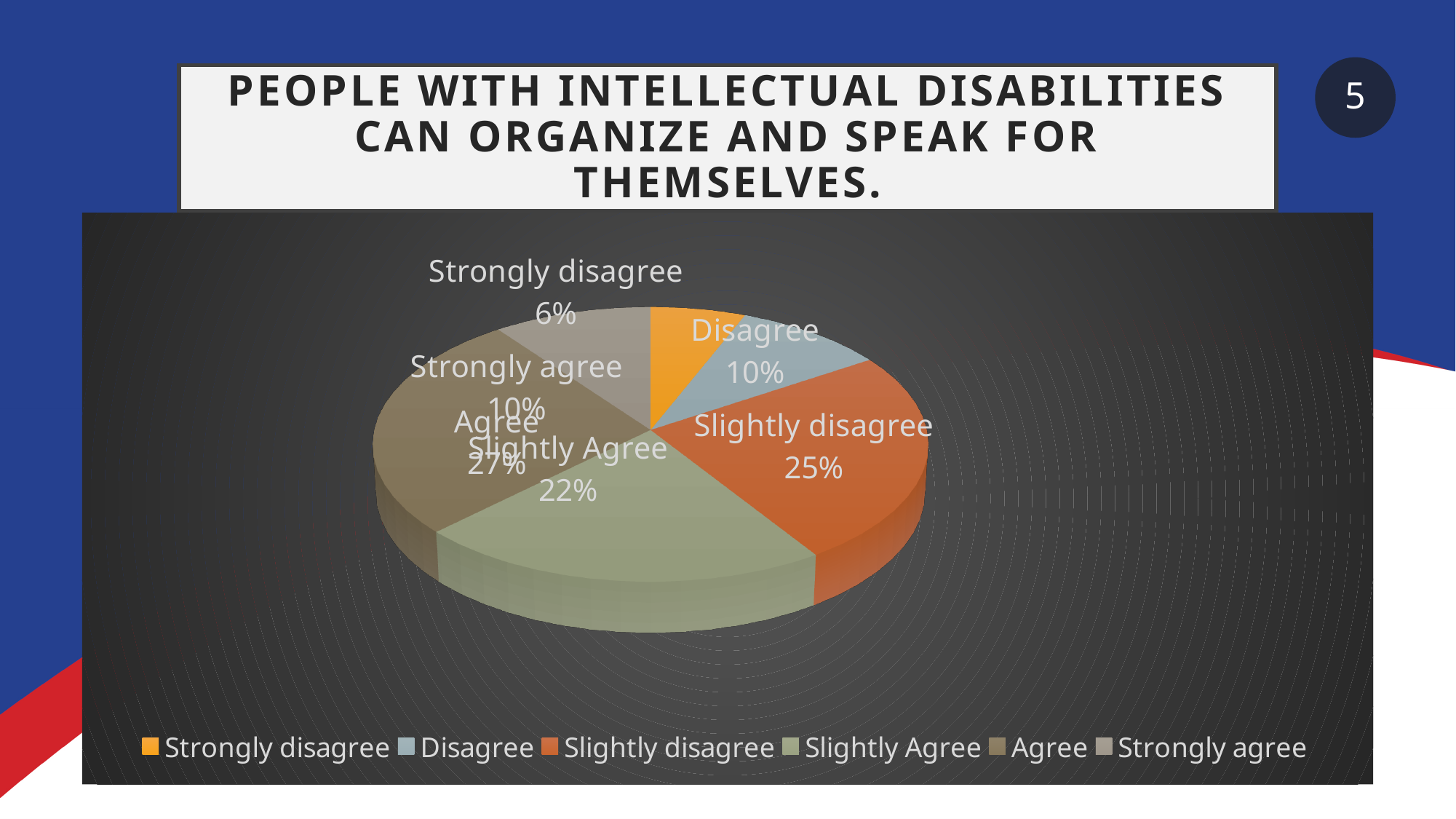
What kind of chart is shown on the slide? Pie chart What percentage of respondents chose Strongly disagree? 6% What percentage of respondents chose Slightly disagree? 25% What percentage of respondents chose Slightly Agree? 22% Which is larger, the share for Disagree or the share for Strongly disagree? Disagree Which colour represents Strongly disagree in the legend? Orange Which response category has the smallest share of the pie? Strongly disagree What percentage of respondents chose Agree? 27% What is the combined percentage for Disagree and Strongly agree? 20% How many categories does the legend list? 6 Which response category has the largest share of the pie? Agree What is the difference in percentage points between Slightly disagree and Slightly Agree? 3